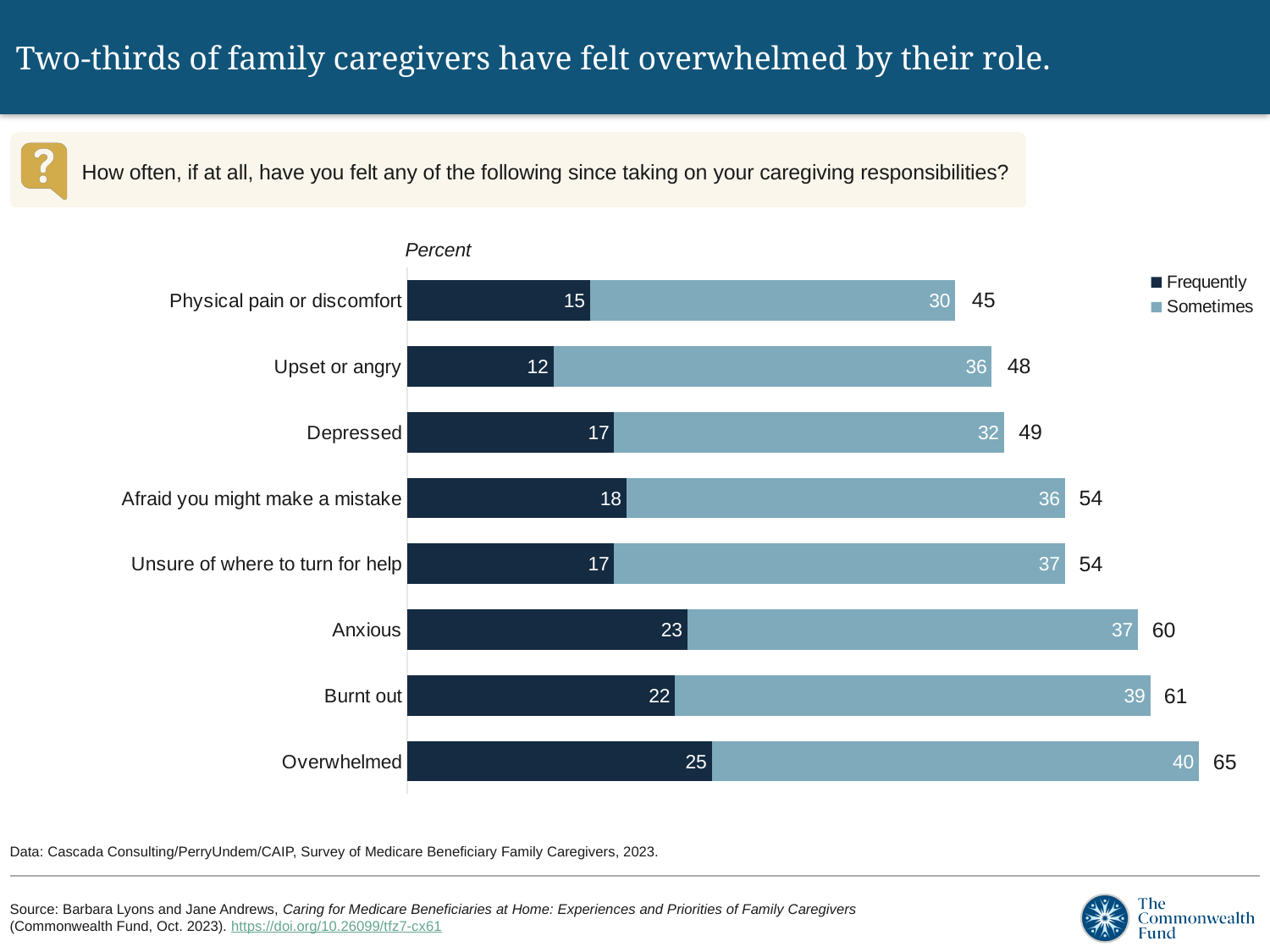
How many categories are shown in the chart? 8 Which category has the lowest combined total? Physical pain or discomfort How many series does the legend list? 2 What type of chart is shown on the slide? Stacked bar chart Which is larger, the 'Frequently' value for 'Anxious' or for 'Burnt out'? Anxious Which series is shown in the dark navy colour? Frequently What percentage of family caregivers reported feeling overwhelmed frequently? 25 What is the difference between the 'Sometimes' and 'Frequently' values for 'Depressed'? 15 Which category has the highest combined total? Overwhelmed What is the 'Sometimes' value for 'Burnt out'? 39 What is the 'Frequently' value for 'Upset or angry'? 12 What is the combined total for 'Anxious'? 60